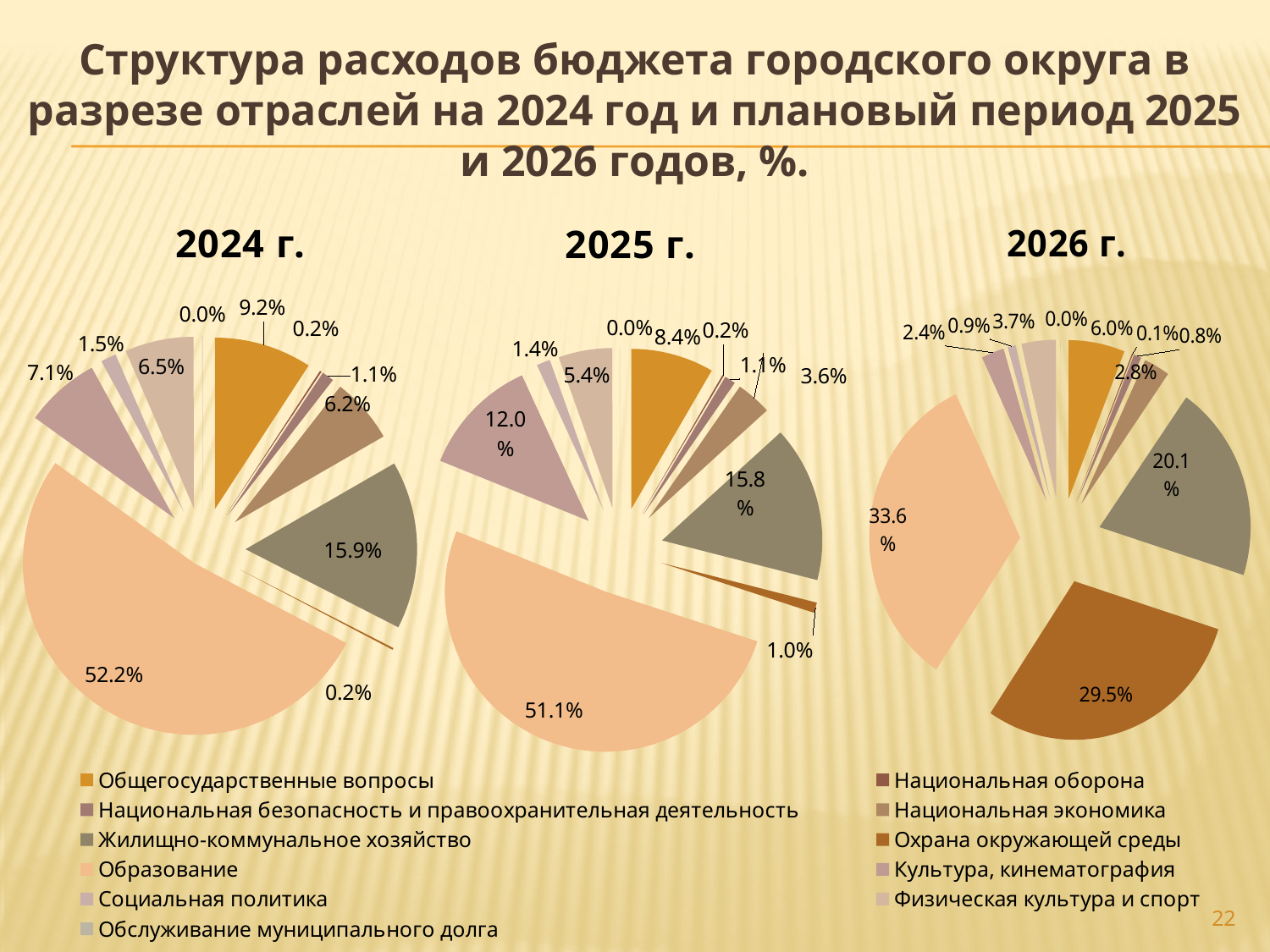
In the 2025 г. chart, what share does Образование have? 51.1% What kind of charts are shown on the slide? Pie charts In the 2026 г. chart, which category has the largest share? Образование In the 2026 г. chart, what share does Образование have? 33.6% How many pie charts are on the slide? 3 In the 2024 г. chart, what share does Жилищно-коммунальное хозяйство have? 15.9% How many categories does the legend list? 11 Does the share of Образование rise or fall from the 2024 г. chart to the 2026 г. chart? Fall In the 2026 г. chart, what share does Охрана окружающей среды have? 29.5% In the 2024 г. chart, what share does Образование have? 52.2% Which is larger in the 2026 г. chart: the share of Жилищно-коммунальное хозяйство or the share of Общегосударственные вопросы? Жилищно-коммунальное хозяйство What is the difference between the Образование share in the 2024 г. chart and in the 2026 г. chart? 18.6%